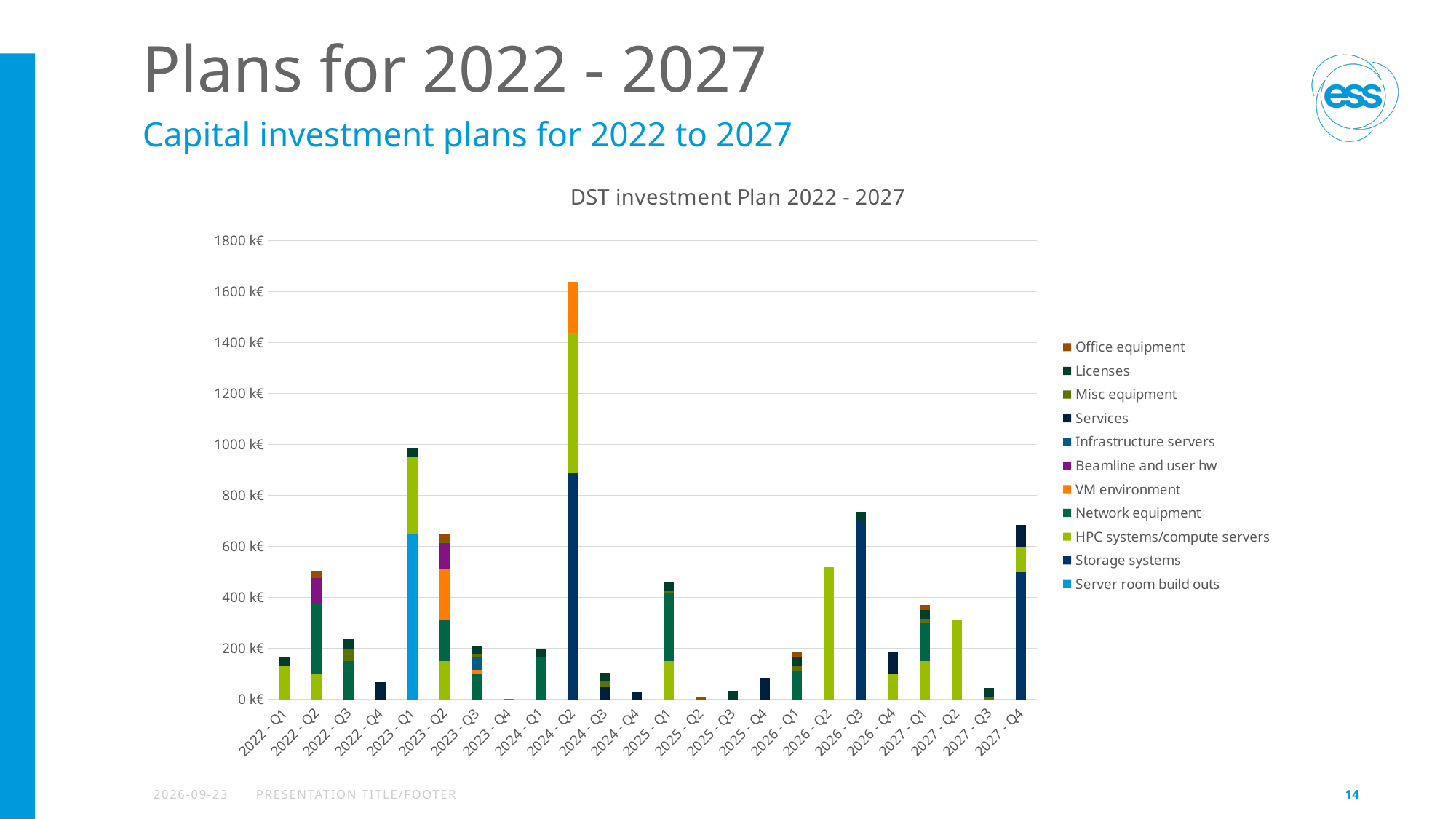
How many quarters are shown along the x axis? 24 Is the total for 2022 - Q4 greater or less than 200 k€? less Which has the larger total, 2023 - Q1 or 2026 - Q3? 2023 - Q1 Which has the larger total, 2022 - Q2 or 2022 - Q3? 2022 - Q2 Is the total for 2024 - Q2 greater or less than 1400 k€? greater Is the total for 2025 - Q1 greater or less than 600 k€? less How many series does the legend list? 11 What is the title of the chart? DST investment Plan 2022 - 2027 What kind of chart is shown on the slide? Stacked bar chart Which quarter has the highest total investment? 2024 - Q2